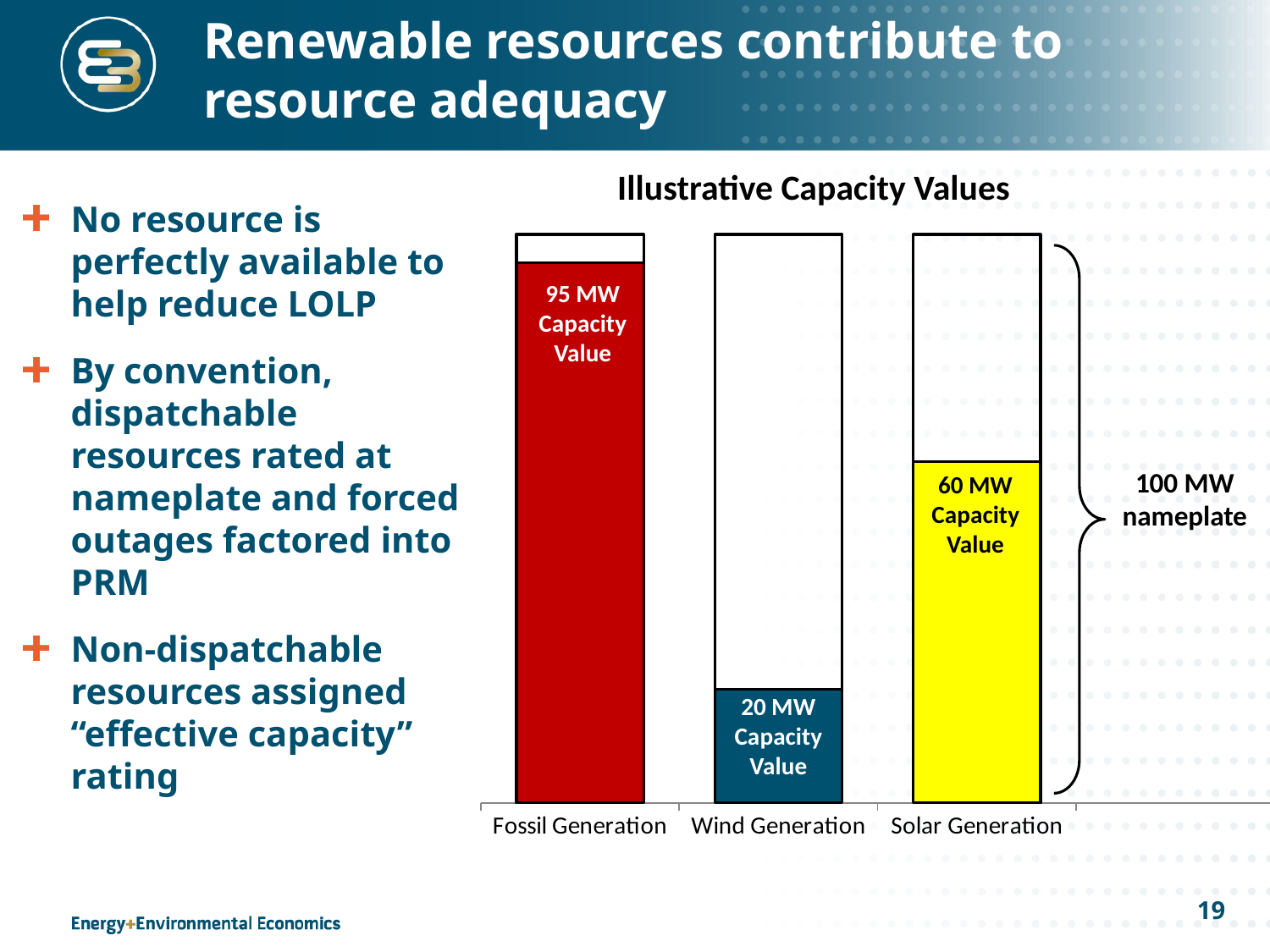
What is the difference between the capacity values of Solar Generation and Wind Generation? 40 MW What is the capacity value shown for Fossil Generation? 95 MW Which has a larger capacity value, Wind Generation or Solar Generation? Solar Generation What nameplate capacity is indicated by the bracket to the right of the bars? 100 MW What is the title of the chart? Illustrative Capacity Values What is the capacity value shown for Wind Generation? 20 MW What kind of chart is shown on the slide? bar chart What is the difference between the capacity values of Fossil Generation and Solar Generation? 35 MW How many categories are shown on the x axis of the chart? 3 Which category has the highest capacity value? Fossil Generation What is the capacity value shown for Solar Generation? 60 MW Which category has the lowest capacity value? Wind Generation